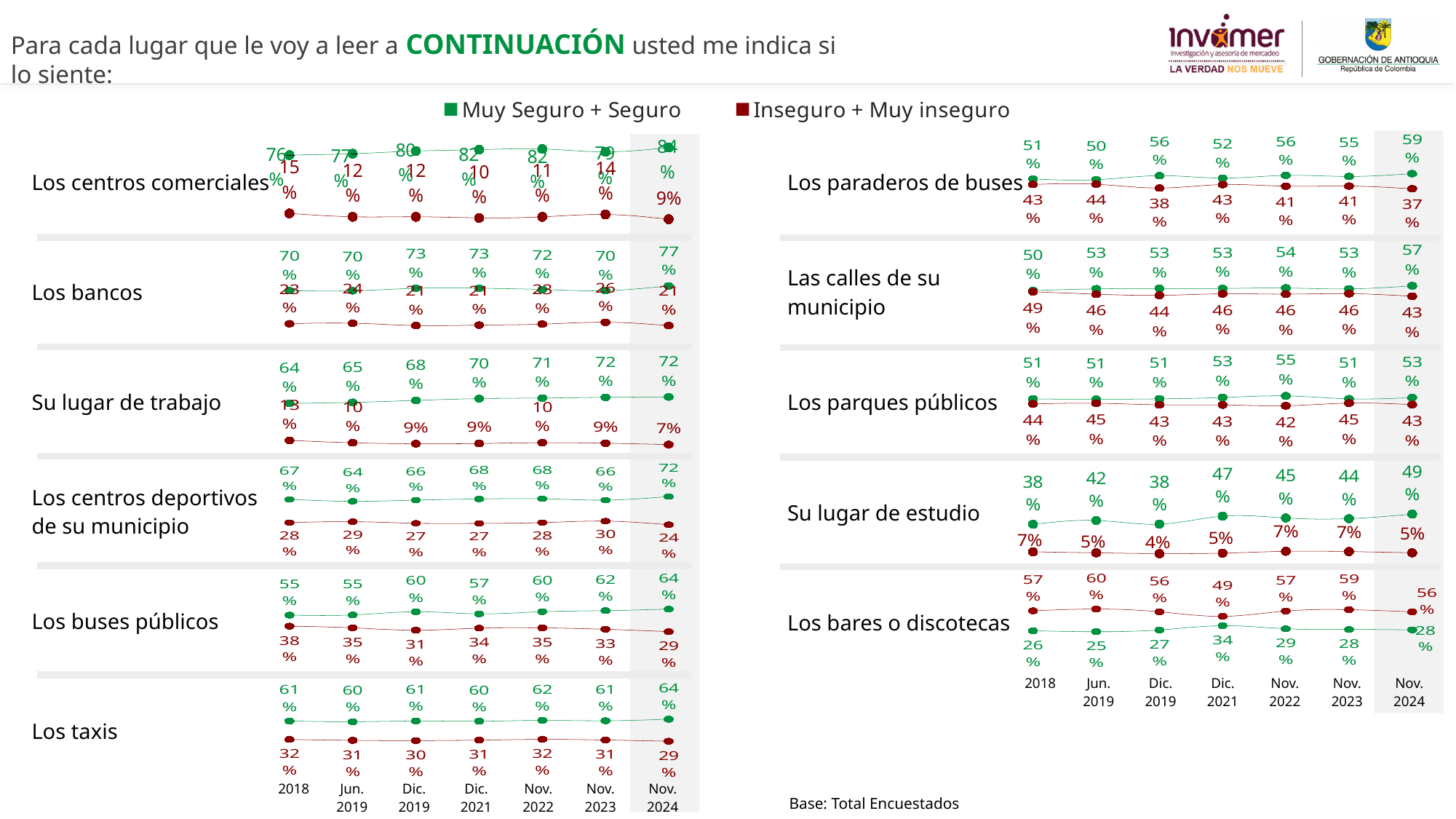
In the 'Los centros deportivos de su municipio' chart, what is the difference between the 'Muy Seguro + Seguro' and 'Inseguro + Muy inseguro' values for Nov. 2024? 48% In the 'Los buses públicos' chart, which period has the highest 'Muy Seguro + Seguro' value? Nov. 2024 In the 'Su lugar de trabajo' chart, what is the 'Inseguro + Muy inseguro' value for Nov. 2024? 7% In the 'Los taxis' chart, which period has the lowest 'Inseguro + Muy inseguro' value? Nov. 2024 In the 'Los bancos' chart, what is the 'Inseguro + Muy inseguro' value for Nov. 2023? 26% How many time periods are shown on the x axis of each chart? 7 In the 'Los bares o discotecas' chart, which is larger in Nov. 2024: 'Muy Seguro + Seguro' or 'Inseguro + Muy inseguro'? Inseguro + Muy inseguro What type of chart is used for 'Las calles de su municipio'? Line chart In the 'Su lugar de estudio' chart, what is the 'Muy Seguro + Seguro' value for Dic. 2021? 47% How many series does the legend list? 2 In the 'Los paraderos de buses' chart, what is the 'Inseguro + Muy inseguro' value for Dic. 2019? 38% In the 'Los centros comerciales' chart, what is the 'Muy Seguro + Seguro' value for Nov. 2024? 84%